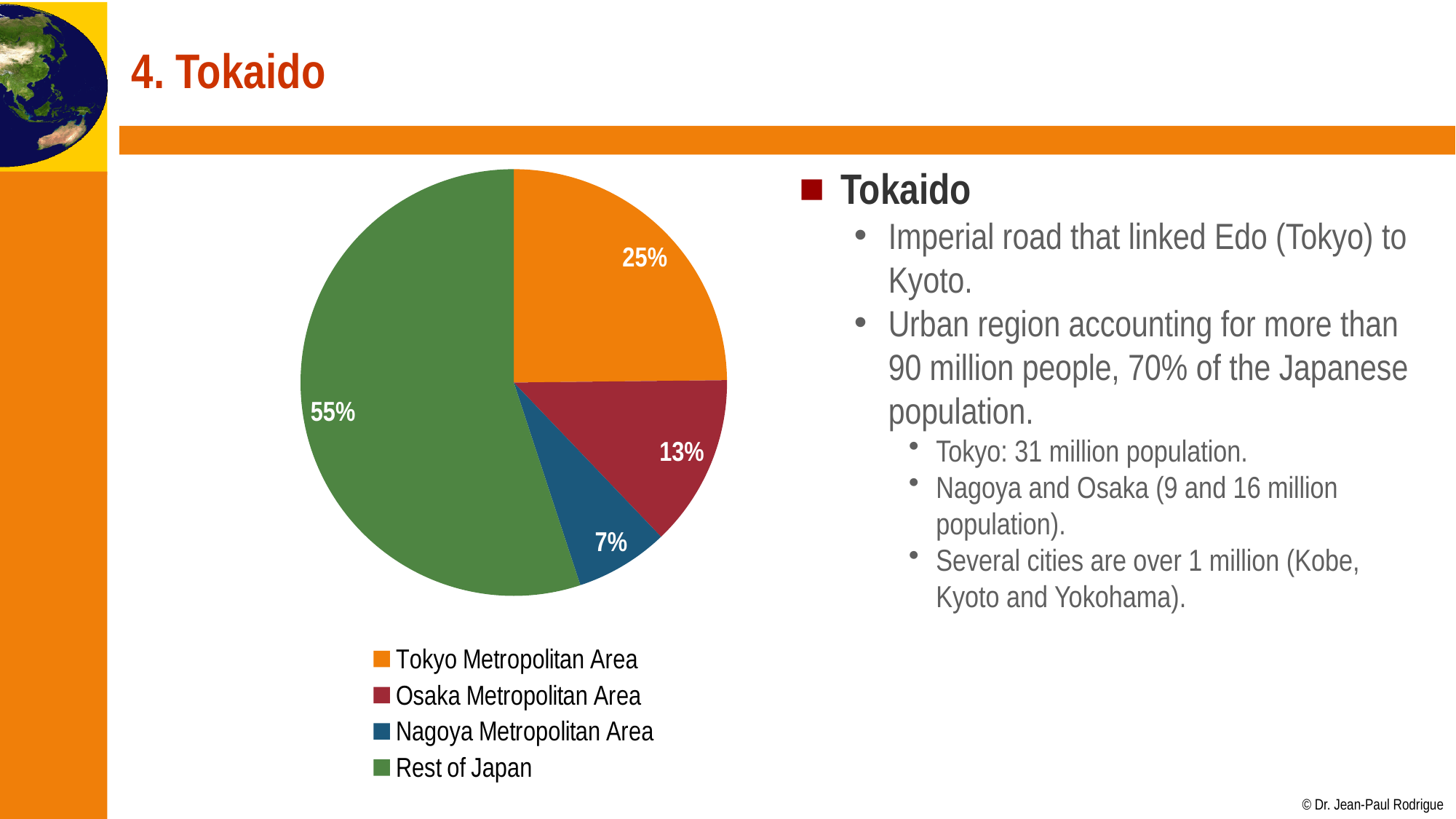
What share of the pie does the Nagoya Metropolitan Area slice represent? 7% What share of the pie does the Rest of Japan slice represent? 55% What is the difference in percentage points between the Tokyo Metropolitan Area and Osaka Metropolitan Area slices? 12 How many slices does the pie chart have? 4 What kind of chart is shown on the slide? Pie chart Which legend entry is shown in orange? Tokyo Metropolitan Area What share of the pie does the Tokyo Metropolitan Area slice represent? 25% Which is larger, the Osaka Metropolitan Area slice or the Nagoya Metropolitan Area slice? Osaka Metropolitan Area Which slice of the pie chart is the smallest? Nagoya Metropolitan Area Which slice of the pie chart is the largest? Rest of Japan What colour is the Rest of Japan slice in the pie chart? Green